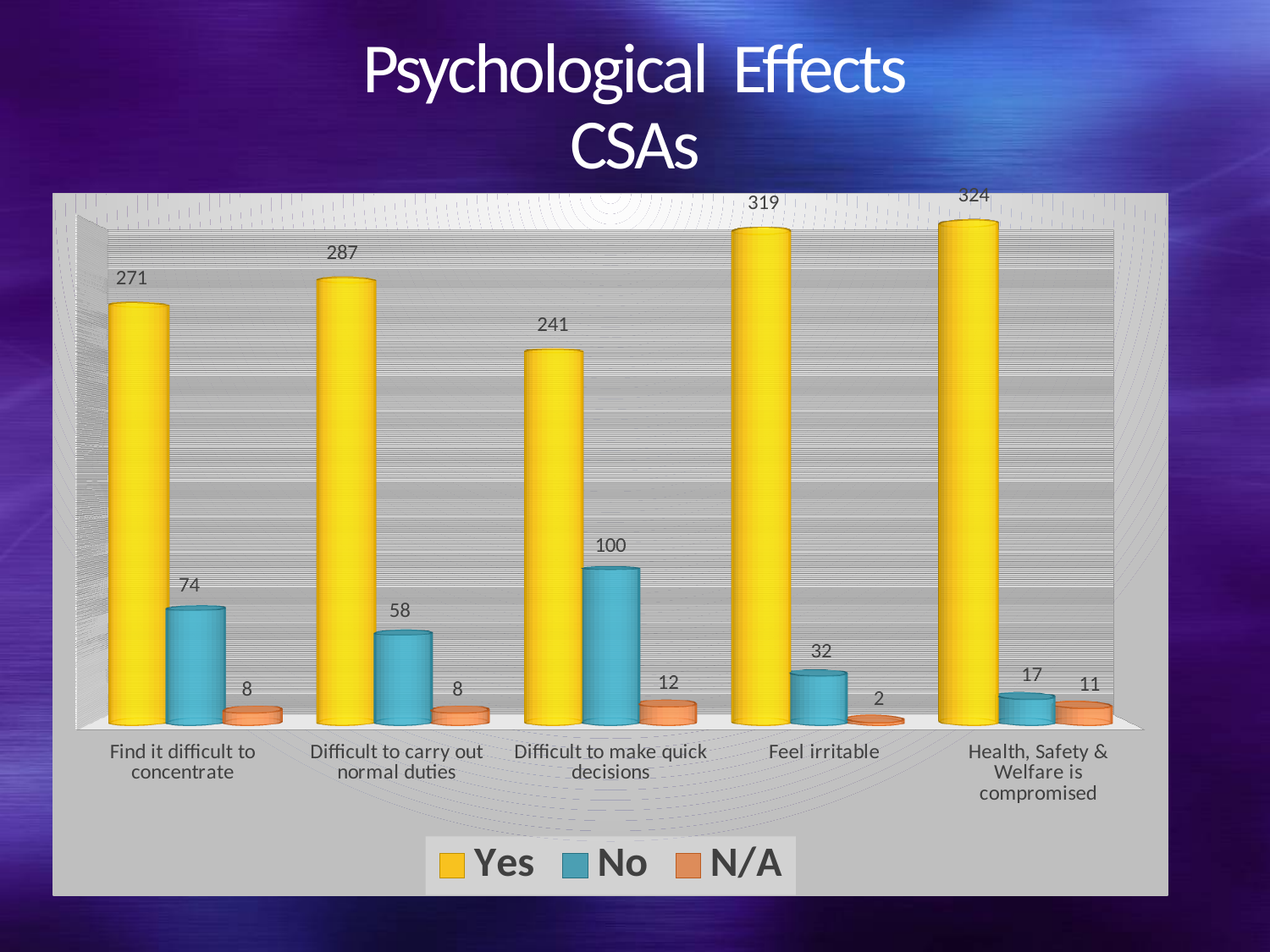
How many series does the legend list? 3 What is the 'N/A' value for 'Health, Safety & Welfare is compromised'? 11 What kind of chart is shown on the slide? Bar chart Which is larger: the 'No' value for 'Find it difficult to concentrate' or the 'No' value for 'Difficult to carry out normal duties'? Find it difficult to concentrate How many categories are shown on the x axis? 5 What is the 'No' value for 'Difficult to make quick decisions'? 100 What is the 'Yes' value for 'Feel irritable'? 319 What is the total of the 'Yes', 'No' and 'N/A' values for 'Feel irritable'? 353 Which series is shown in yellow in the legend? Yes Which category has the highest 'Yes' value? Health, Safety & Welfare is compromised What is the difference between the 'Yes' values for 'Difficult to carry out normal duties' and 'Find it difficult to concentrate'? 16 Which category has the lowest 'N/A' value? Feel irritable